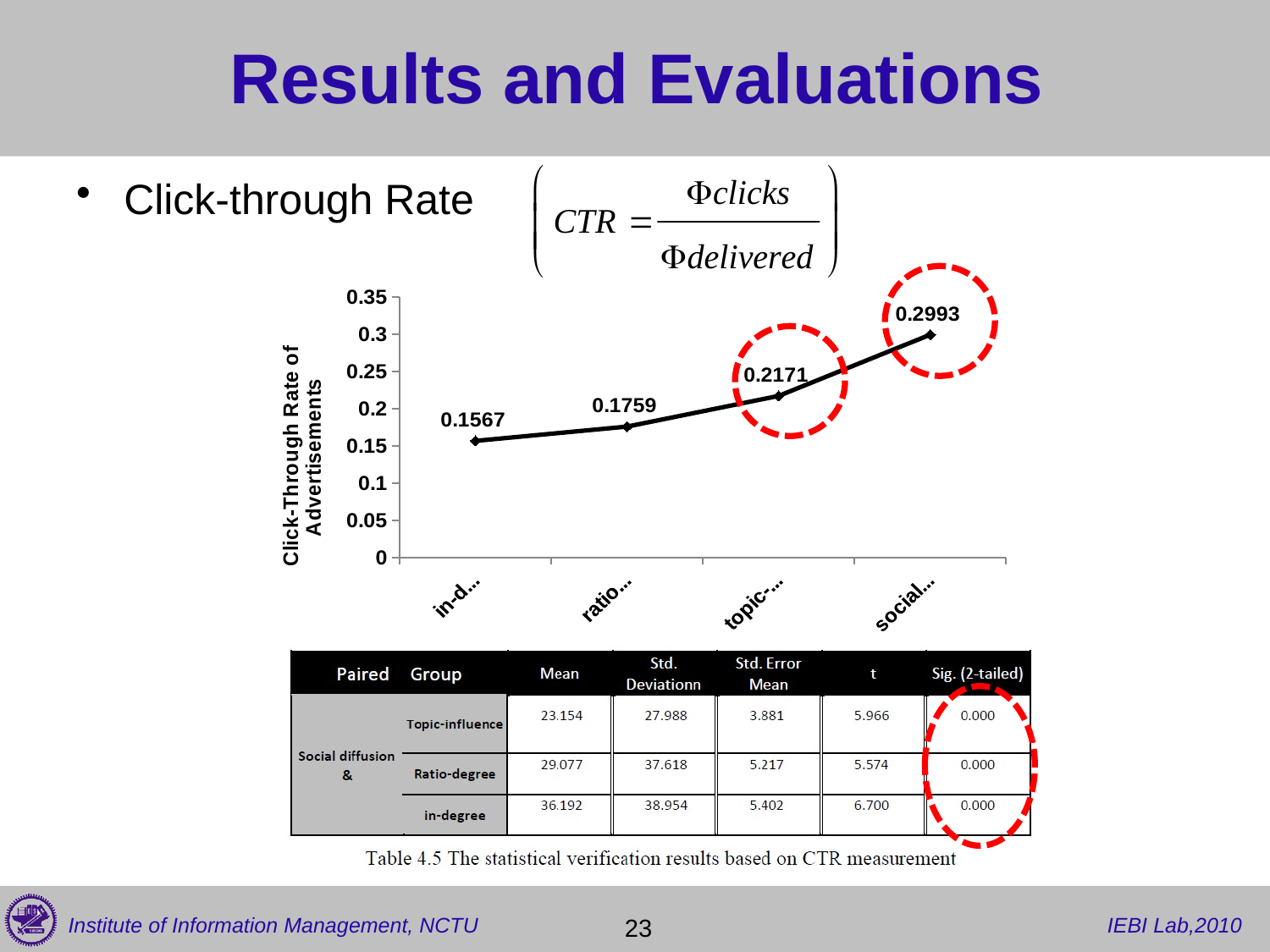
What is the click-through rate value for the first category (labelled "in-d...") in the line chart? 0.1567 Which category has the highest click-through rate in the line chart? social... What is the click-through rate value for the category labelled "topic-..." in the line chart? 0.2171 What is the click-through rate value for the last category (labelled "social...") in the line chart? 0.2993 What type of chart is used to show the click-through rate of advertisements? Line chart What is the click-through rate value for the category labelled "ratio..." in the line chart? 0.1759 Which has a larger click-through rate, the "ratio..." category or the "topic-..." category? topic-... What is the difference between the click-through rate values for "topic-..." and "ratio..."? 0.0412 Do the click-through rate values rise or fall from left to right along the x axis? Rise How many data points are plotted in the line chart? 4 Which category has the lowest click-through rate in the line chart? in-d... What is the difference between the click-through rate of the last category ("social...") and the first category ("in-d...")? 0.1426